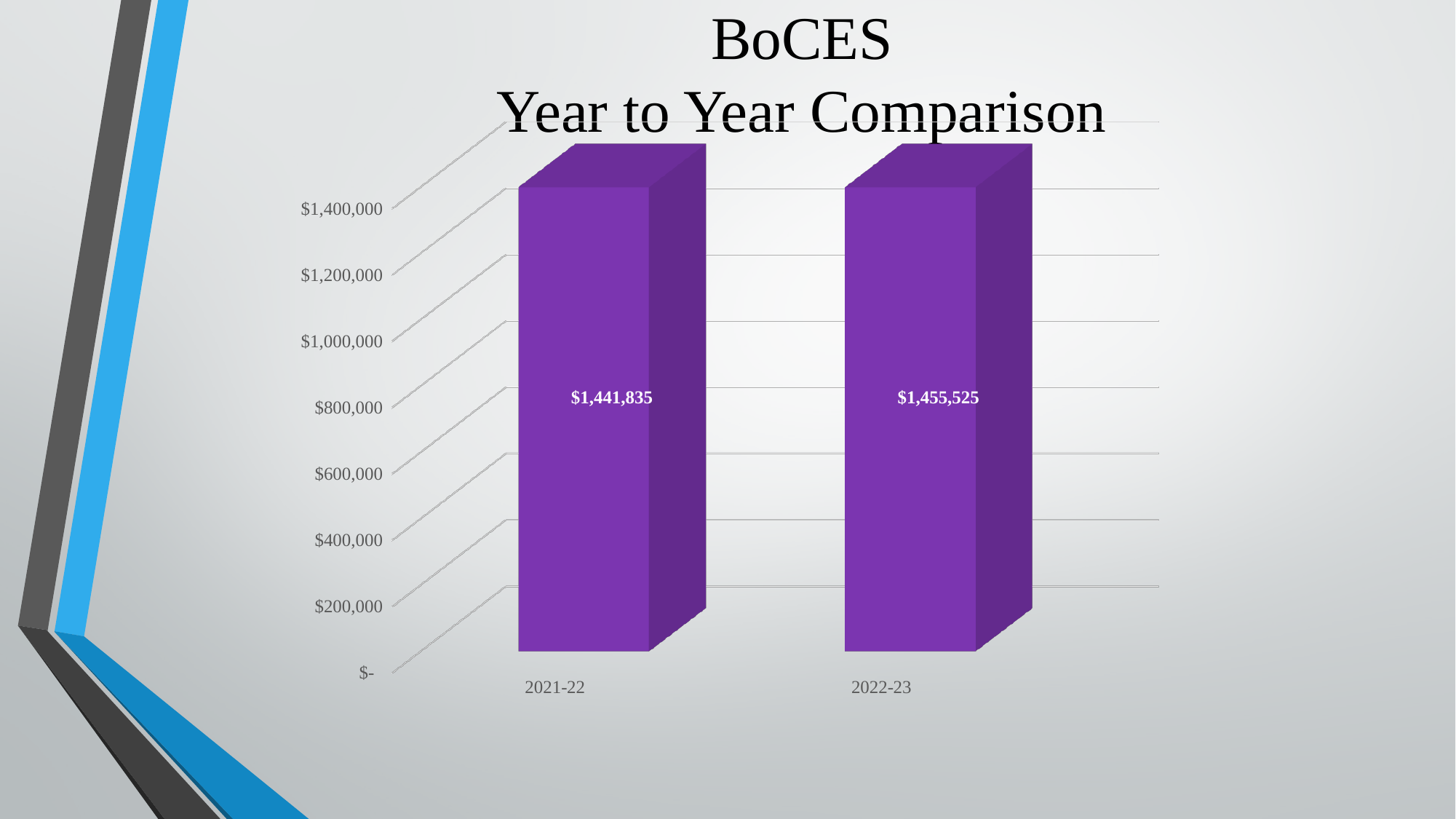
Is the value for 2022-23 larger or smaller than the value for 2021-22? larger What is the difference between the 2022-23 value and the 2021-22 value? $13,690 What is the value for 2021-22? $1,441,835 What is the value for 2022-23? $1,455,525 What is the title of the chart? BoCES Year to Year Comparison Is the value for 2021-22 greater or less than $1,200,000? greater Which year has the higher value? 2022-23 How many years are shown on the chart? 2 Do the values rise or fall from 2021-22 to 2022-23? rise What kind of chart is shown on the slide? bar chart Which year has the lower value? 2021-22 Is the value for 2022-23 greater or less than $1,000,000? greater